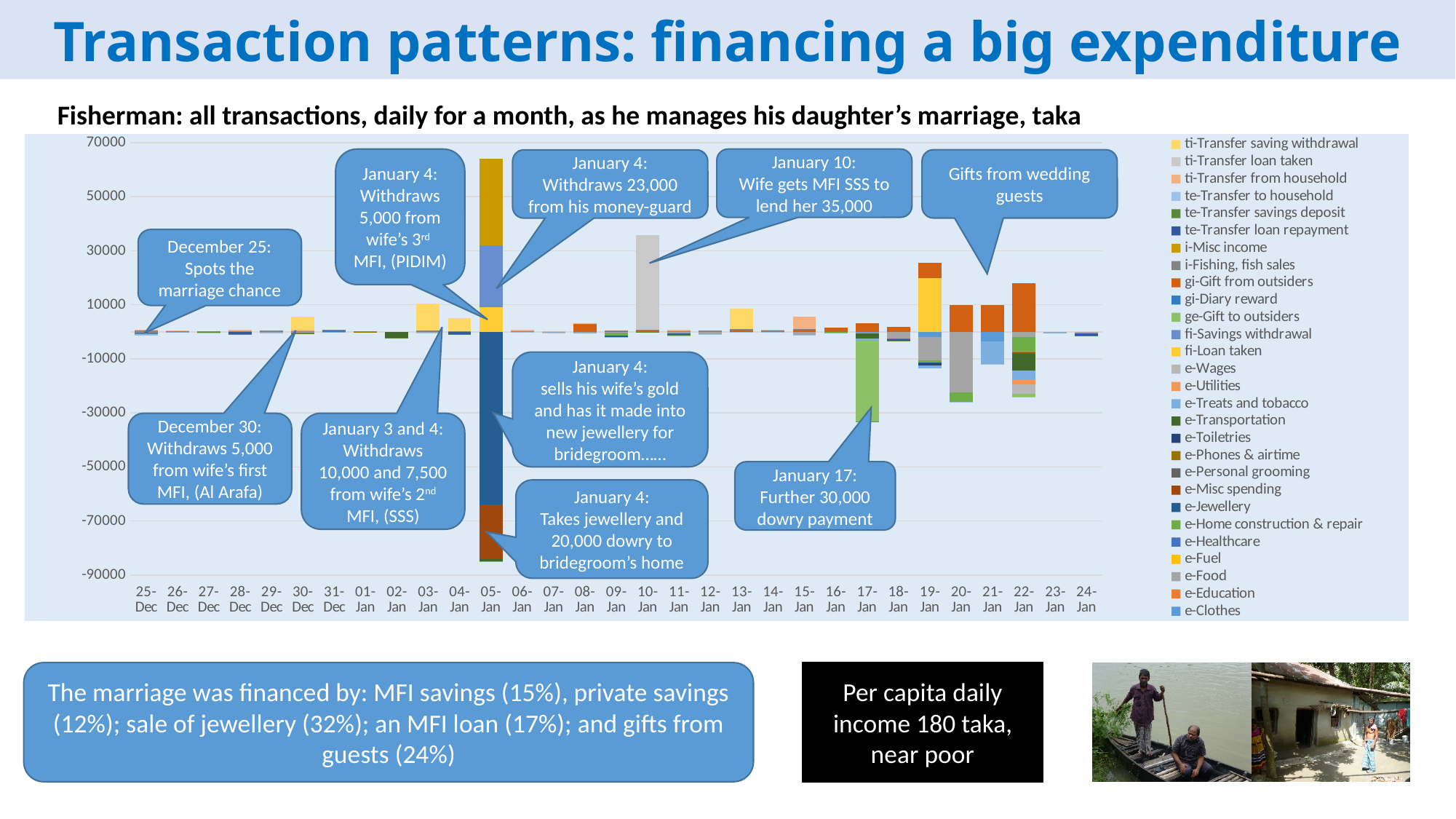
How many days (categories) are shown along the x axis of the chart? 31 Which day has the largest negative (lowest) stacked bar in the chart? 05-Jan How many series does the chart legend list? 28 What is the lowest value shown on the y axis of the chart? -90000 Is the positive bar for 10-Jan greater or less than 30000? greater Is the top of the positive stacked bar for 05-Jan greater or less than 50000? greater What is the first date shown on the x axis of the chart? 25-Dec What kind of chart is shown on the slide? Stacked bar chart Is the negative bar for 17-Jan greater or less than -30000? less Which day has a taller positive stacked bar, 10-Jan or 19-Jan? 10-Jan Which day has the tallest positive stacked bar in the chart? 05-Jan